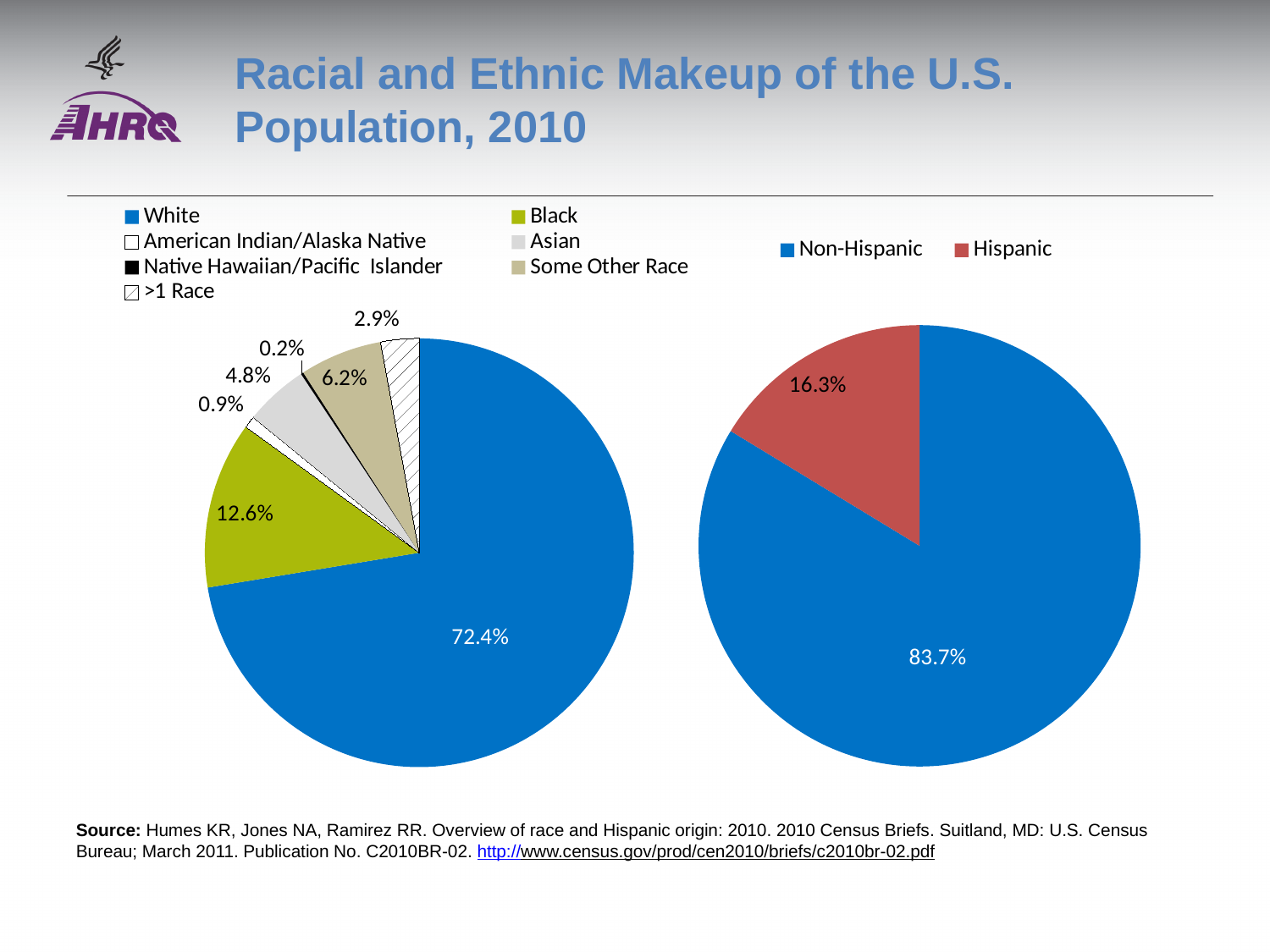
In the right pie chart, what share of the population is Hispanic? 16.3% In the left pie chart, which is larger, the share for Some Other Race or the share for >1 Race? Some Other Race In the left pie chart, which category has the smallest share? Native Hawaiian/Pacific Islander In the left pie chart, what share of the population is Black? 12.6% In the left pie chart, what share of the population is Some Other Race? 6.2% How many categories does the left pie chart's legend list? 7 What type of chart is the right chart? Pie chart In the right pie chart, what share of the population is Non-Hispanic? 83.7% In the left pie chart, which category has the largest share? White In the left pie chart, what share of the population is Asian? 4.8% In the left pie chart, what is the difference between the Black share and the Asian share? 7.8% In the left pie chart, what share of the population is White? 72.4%